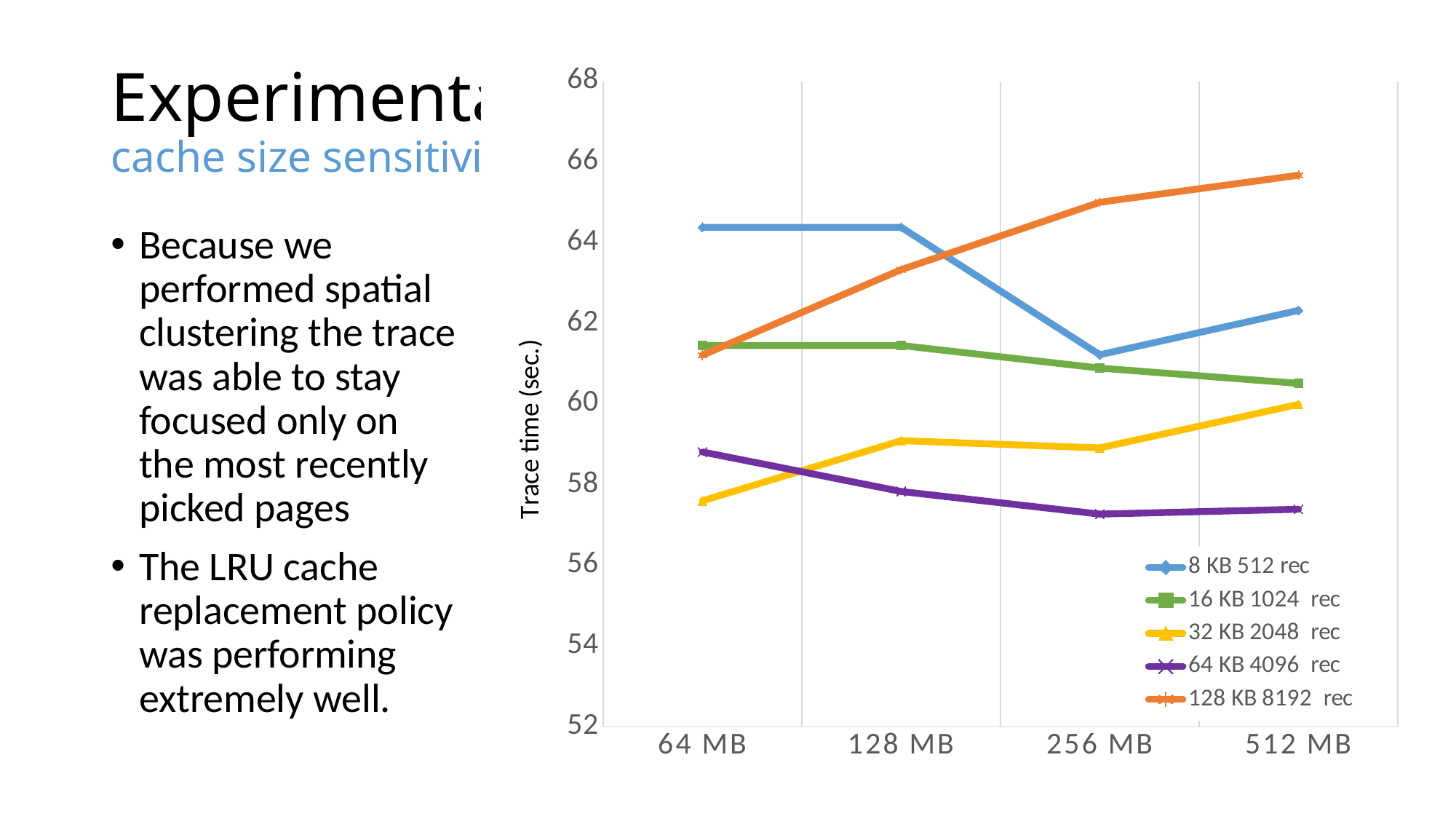
Is the trace time for 128 KB 8192 rec at 512 MB greater or less than 64? greater What is the label of the y axis? Trace time (sec.) Is the trace time for 32 KB 2048 rec at 64 MB greater or less than 58? less Is the trace time for 64 KB 4096 rec at 256 MB greater or less than 58? less How many cache sizes are shown along the x axis? 4 Which series has the lowest trace time at 512 MB? 64 KB 4096 rec Which series has the highest trace time at 512 MB? 128 KB 8192 rec Which series has the highest trace time at 64 MB? 8 KB 512 rec At 128 MB, which has the larger trace time: 8 KB 512 rec or 128 KB 8192 rec? 8 KB 512 rec What kind of chart is shown on the slide? Line chart Does the trace time for 128 KB 8192 rec rise or fall as cache size increases from 64 MB to 512 MB? rise How many series does the legend list? 5